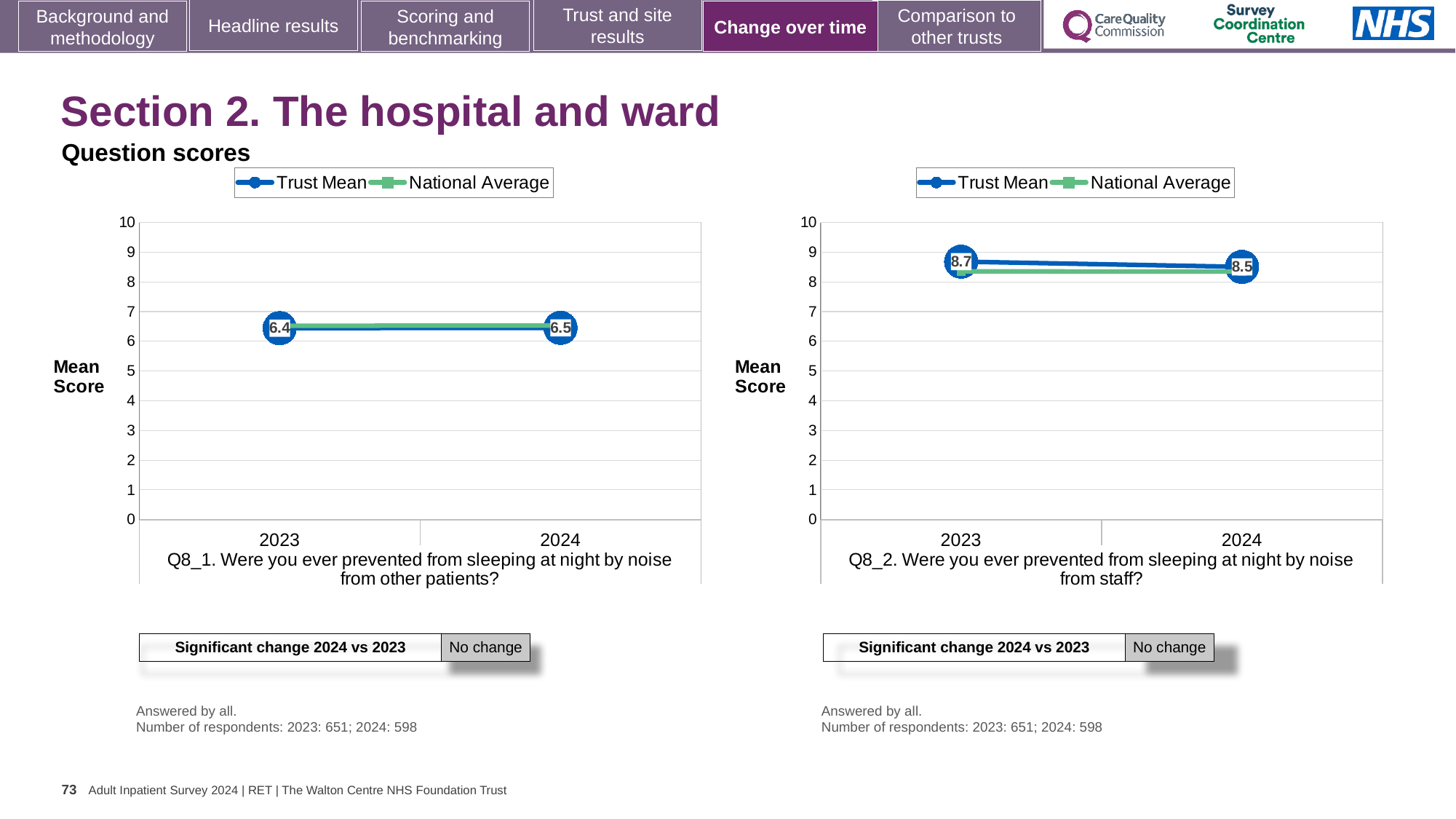
In the right chart (Q8_2, noise from staff), is the Trust Mean for 2023 greater or less than 8? greater How many years are plotted on the x axis of the left chart (Q8_1)? 2 In the left chart (Q8_1, noise from other patients), what is the Trust Mean for 2024? 6.5 In the left chart (Q8_1, noise from other patients), what is the difference between the Trust Mean for 2024 and 2023? 0.1 In the right chart (Q8_2, noise from staff), what is the Trust Mean for 2023? 8.7 In the right chart (Q8_2, noise from staff), what is the difference between the Trust Mean for 2023 and 2024? 0.2 In the right chart (Q8_2, noise from staff), what is the Trust Mean for 2024? 8.5 In the right chart (Q8_2, noise from staff), does the Trust Mean rise or fall from 2023 to 2024? fall What kind of chart is the right chart (Q8_2, noise from staff)? line chart In the left chart (Q8_1, noise from other patients), is the Trust Mean for 2024 greater or less than 7? less In the left chart (Q8_1, noise from other patients), what is the Trust Mean for 2023? 6.4 How many series does the legend of the left chart (Q8_1) list? 2